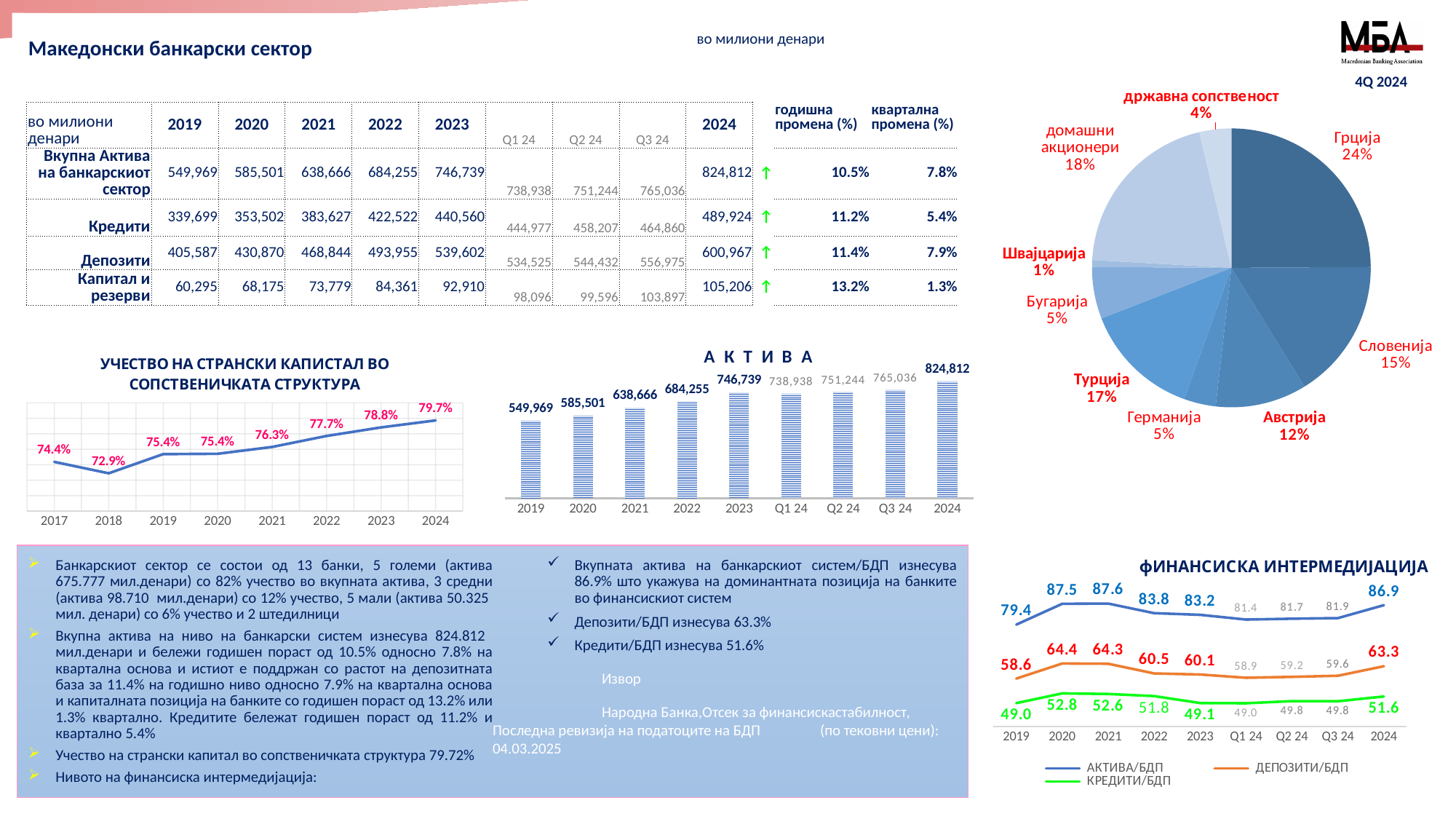
In the 'УЧЕСТВО НА СТРАНСКИ КАПИСТАЛ ВО СОПСТВЕНИЧКАТА СТРУКТУРА' chart, which year has the highest value? 2024 In the pie chart at the top right, what share does Грција hold? 24% How many bars are shown in the 'АКТИВА' chart? 9 What kind of chart is the 'АКТИВА' chart? bar chart In the 'УЧЕСТВО НА СТРАНСКИ КАПИСТАЛ ВО СОПСТВЕНИЧКАТА СТРУКТУРА' chart, what is the value for 2018? 72.9% In the pie chart at the top right, which is larger: the share for Турција or the share for Словенија? Турција In the 'УЧЕСТВО НА СТРАНСКИ КАПИСТАЛ ВО СОПСТВЕНИЧКАТА СТРУКТУРА' chart, which year has the lowest value? 2018 How many series does the legend of the 'ФИНАНСИСКА ИНТЕРМЕДИЈАЦИЈА' chart list? 3 In the 'АКТИВА' chart, what is the difference between the 2024 value and the 2023 value? 78,073 In the 'АКТИВА' chart, what is the value for 2024? 824,812 In the 'АКТИВА' chart, what is the value for Q2 24? 751,244 In the 'ФИНАНСИСКА ИНТЕРМЕДИЈАЦИЈА' chart, what is the value of ДЕПОЗИТИ/БДП for 2024? 63.3